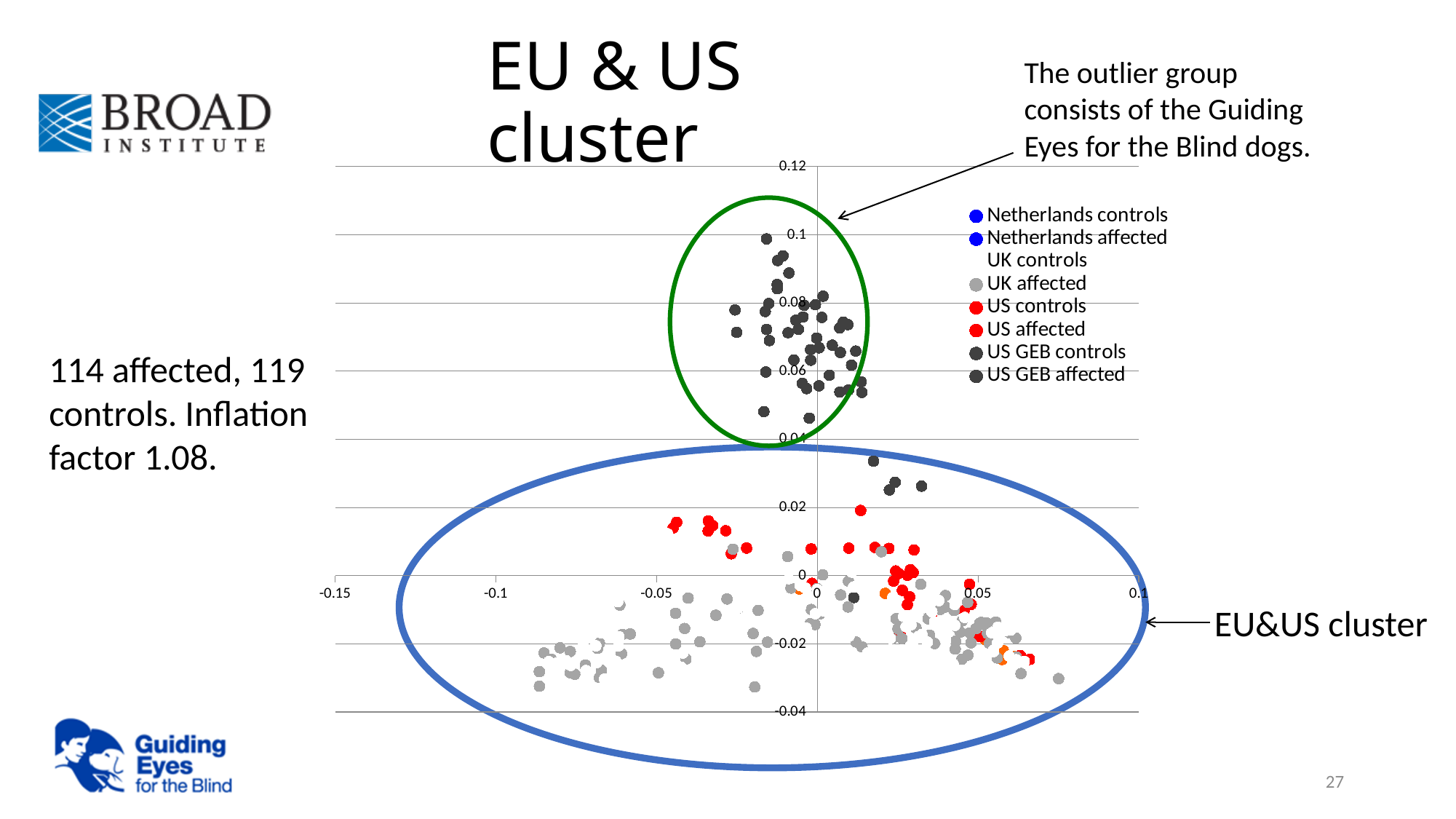
What is the title of the chart? EU & US cluster Is the rightmost point on the chart greater or less than 0.1 on the horizontal axis? less How many series does the chart's legend list? 8 What kind of chart is shown on the slide? scatter plot Is the lowest point on the chart greater or less than -0.04 on the vertical axis? greater Are the red US points greater or less than 0.04 on the vertical axis? less Which group of points sits higher on the vertical axis: the points in the green circle or the points in the blue ellipse? the points in the green circle According to the annotation, which dogs make up the outlier group circled in green? Guiding Eyes for the Blind dogs